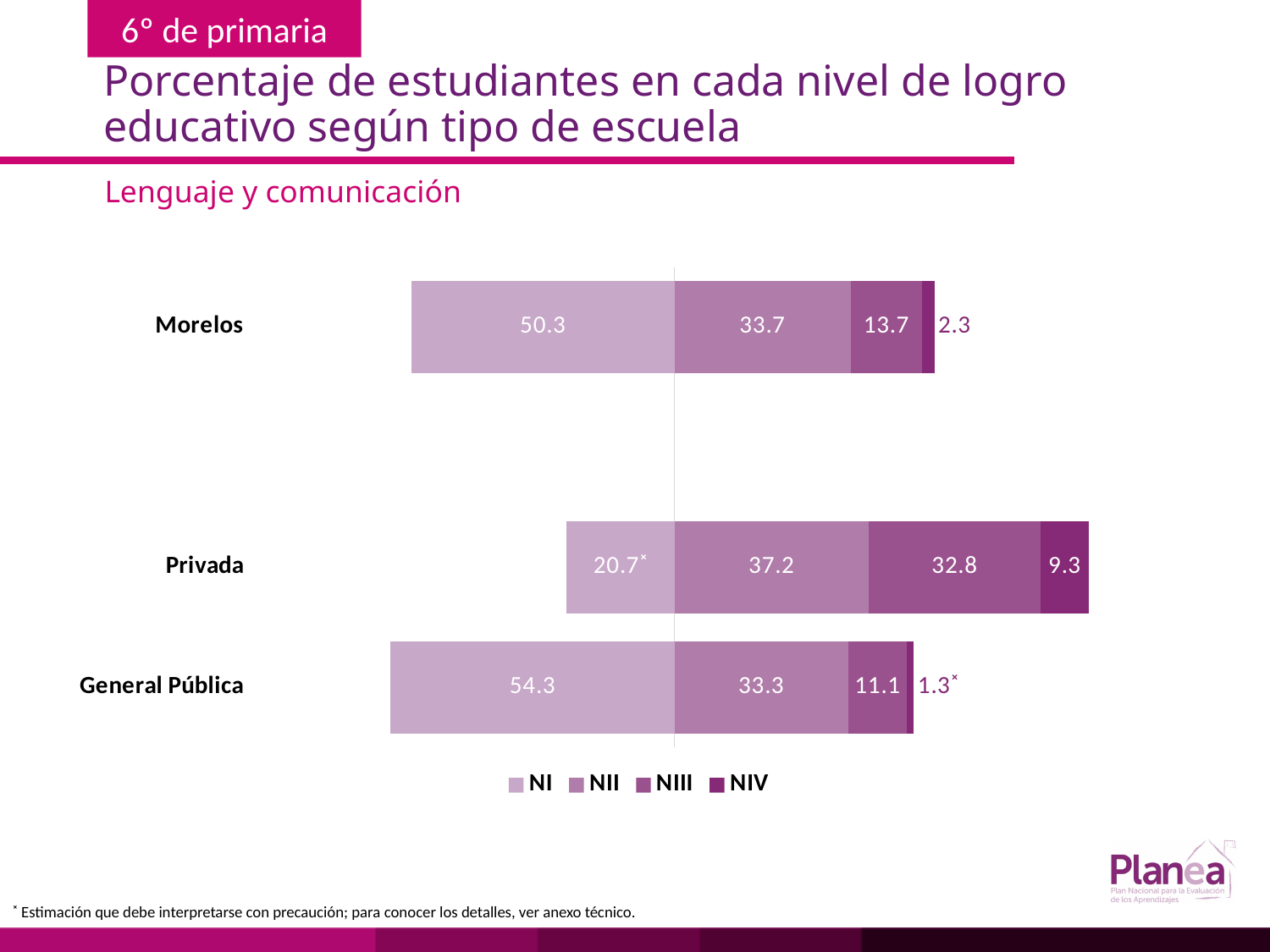
Which school type has the highest NI value? General Pública What is the total of the stacked bar for Privada? 100.0 What is the NI value for Morelos? 50.3 What is the NII value for Privada? 37.2 How many series does the legend list? 4 Which is larger, the NII value for Morelos or the NII value for General Pública? Morelos What is the difference between the NIII values for Privada and Morelos? 19.1 How many school types (categories) are shown in the chart? 3 What kind of chart is shown on the slide? Stacked bar chart Which school type has the lowest NIV value? General Pública What is the NIII value for General Pública? 11.1 What is the NIV value for Privada? 9.3